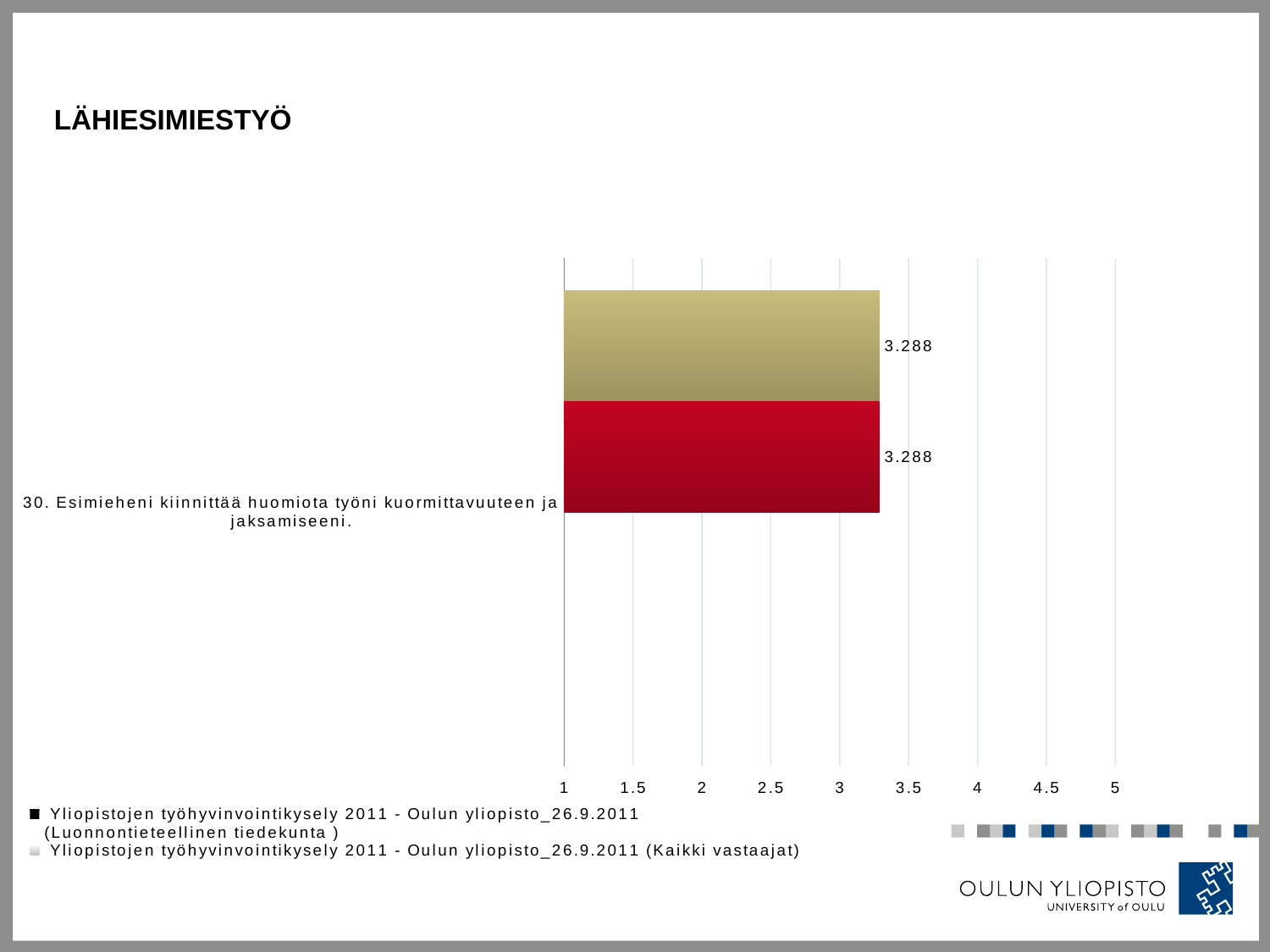
What is the value for 'Yliopistojen työhyvinvointikysely 2011 - Oulun yliopisto_26.9.2011 (Luonnontieteellinen tiedekunta)' for item 30? 3.288 Is the value for the Luonnontieteellinen tiedekunta series greater or less than 3? greater What is the difference between the two bars' values for item 30? 0 How many categories (survey items) are plotted on the chart? 1 What kind of chart is shown on the slide? bar chart Do the two series have the same value for item 30? Yes, both are 3.288 Is the value for the Kaikki vastaajat series greater or less than 3.5? less How many series does the legend list? 2 What is the title of the slide? LÄHIESIMIESTYÖ What is the highest value shown on the x axis? 5 What is the value for 'Yliopistojen työhyvinvointikysely 2011 - Oulun yliopisto_26.9.2011 (Kaikki vastaajat)' for item 30? 3.288